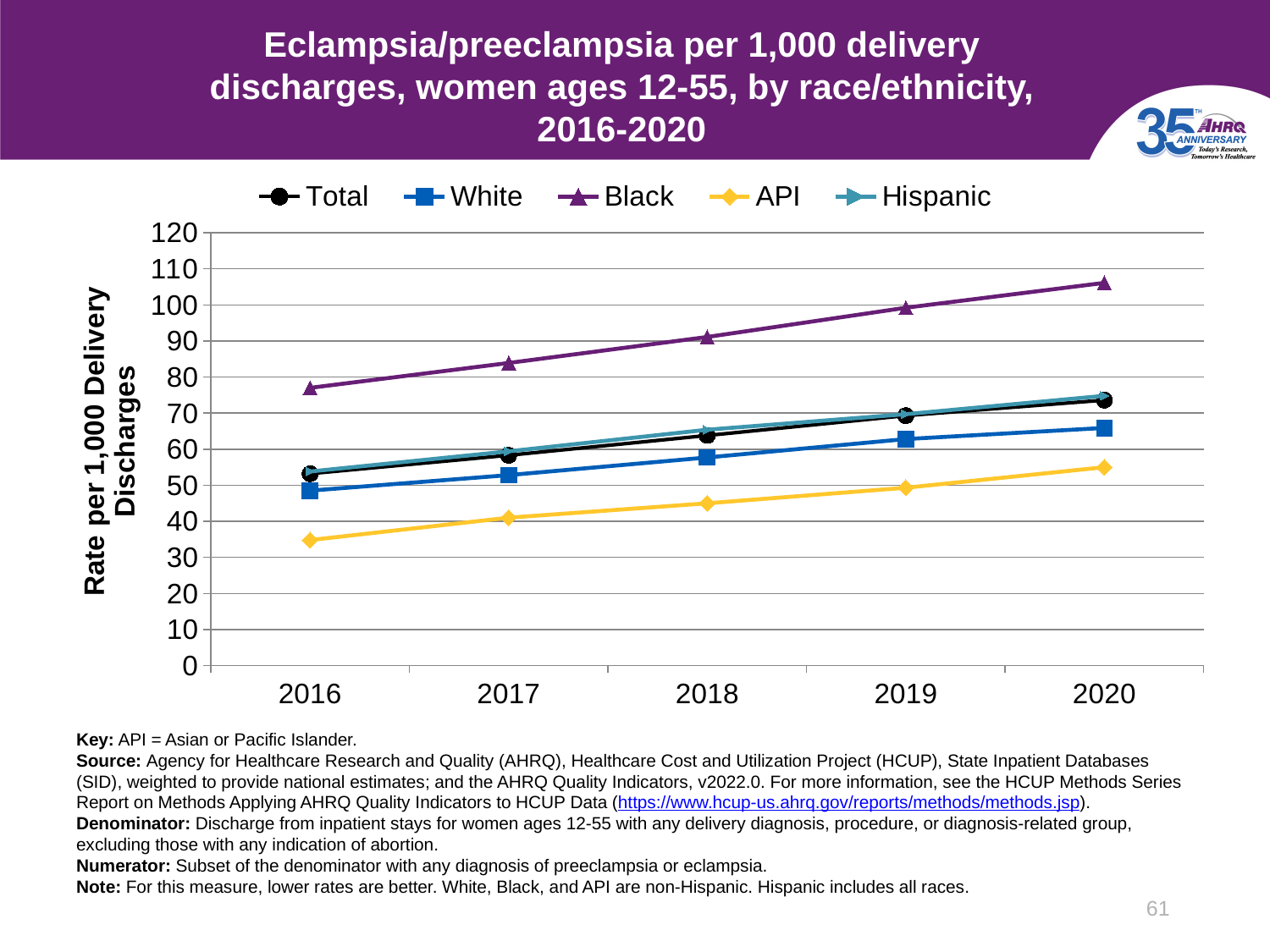
What kind of chart is shown on the slide? line chart Does the rate for Black rise or fall from 2016 to 2020? rise Which race/ethnicity group has the lowest rate in 2016? API Is the value for White in 2020 greater or less than 60? greater Is the value for Black in 2020 greater or less than 100? greater What does API stand for according to the key on the slide? Asian or Pacific Islander How many series does the legend list? 5 How many years are plotted along the x axis? 5 In 2018, which is larger, the rate for Black or the rate for White? Black Which race/ethnicity group has the highest rate in 2020? Black Is the value for API in 2020 greater or less than 50? greater